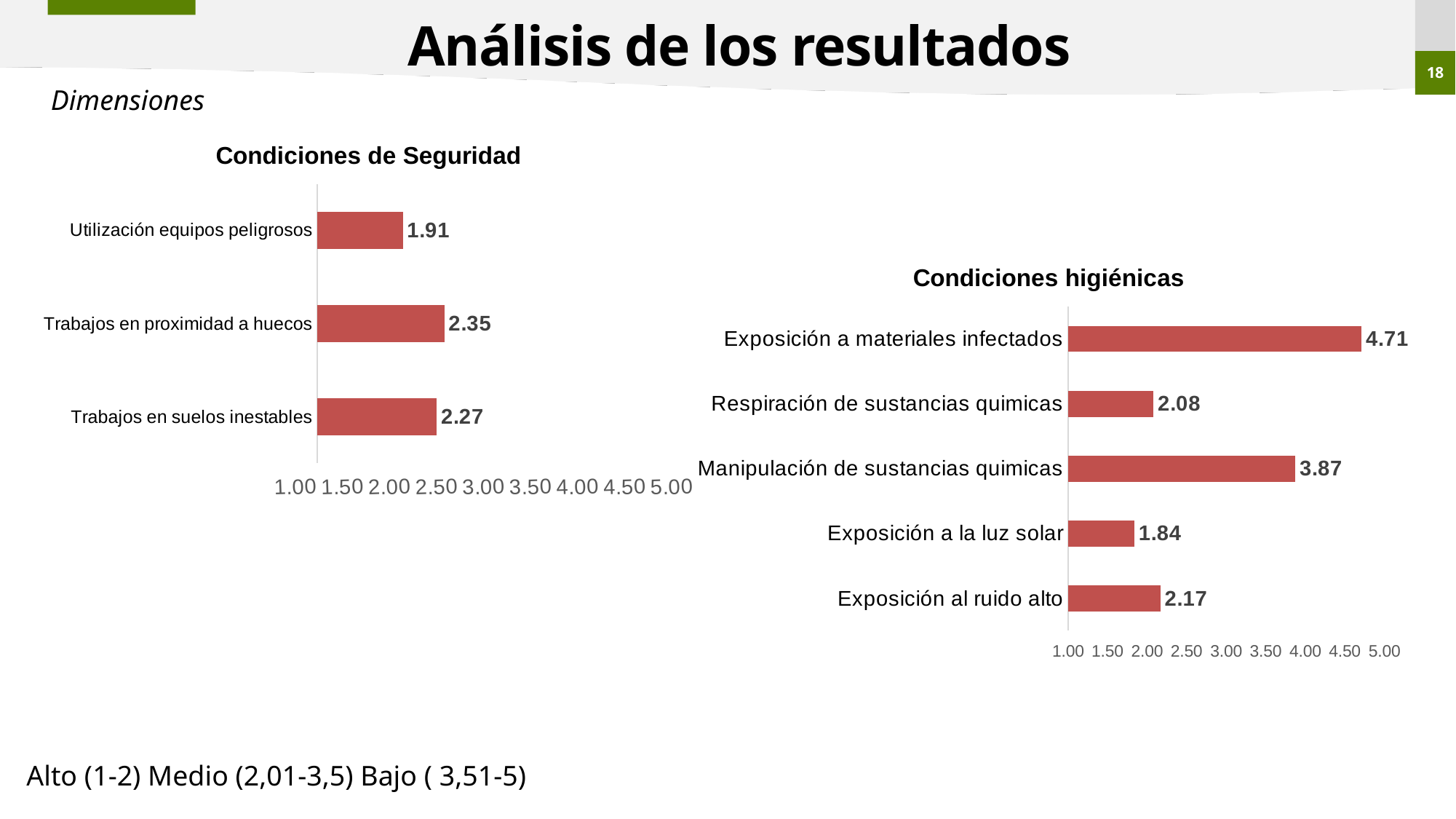
In the 'Condiciones de Seguridad' chart, which category has the lowest value? Utilización equipos peligrosos In the 'Condiciones higiénicas' chart, what is the difference between 'Exposición a materiales infectados' and 'Respiración de sustancias quimicas'? 2.63 In the 'Condiciones de Seguridad' chart, which category has the highest value? Trabajos en proximidad a huecos In the 'Condiciones de Seguridad' chart, what is the difference between 'Trabajos en proximidad a huecos' and 'Trabajos en suelos inestables'? 0.08 In the 'Condiciones higiénicas' chart, how many categories are shown? 5 What type of chart is the 'Condiciones higiénicas' chart? Bar chart In the 'Condiciones de Seguridad' chart, what is the value for 'Utilización equipos peligrosos'? 1.91 In the 'Condiciones higiénicas' chart, what is the value for 'Manipulación de sustancias quimicas'? 3.87 In the 'Condiciones higiénicas' chart, which category has the lowest value? Exposición a la luz solar In the 'Condiciones higiénicas' chart, which category has the highest value? Exposición a materiales infectados In the 'Condiciones higiénicas' chart, which is larger: 'Exposición al ruido alto' or 'Exposición a la luz solar'? Exposición al ruido alto In the 'Condiciones de Seguridad' chart, how many categories are shown? 3